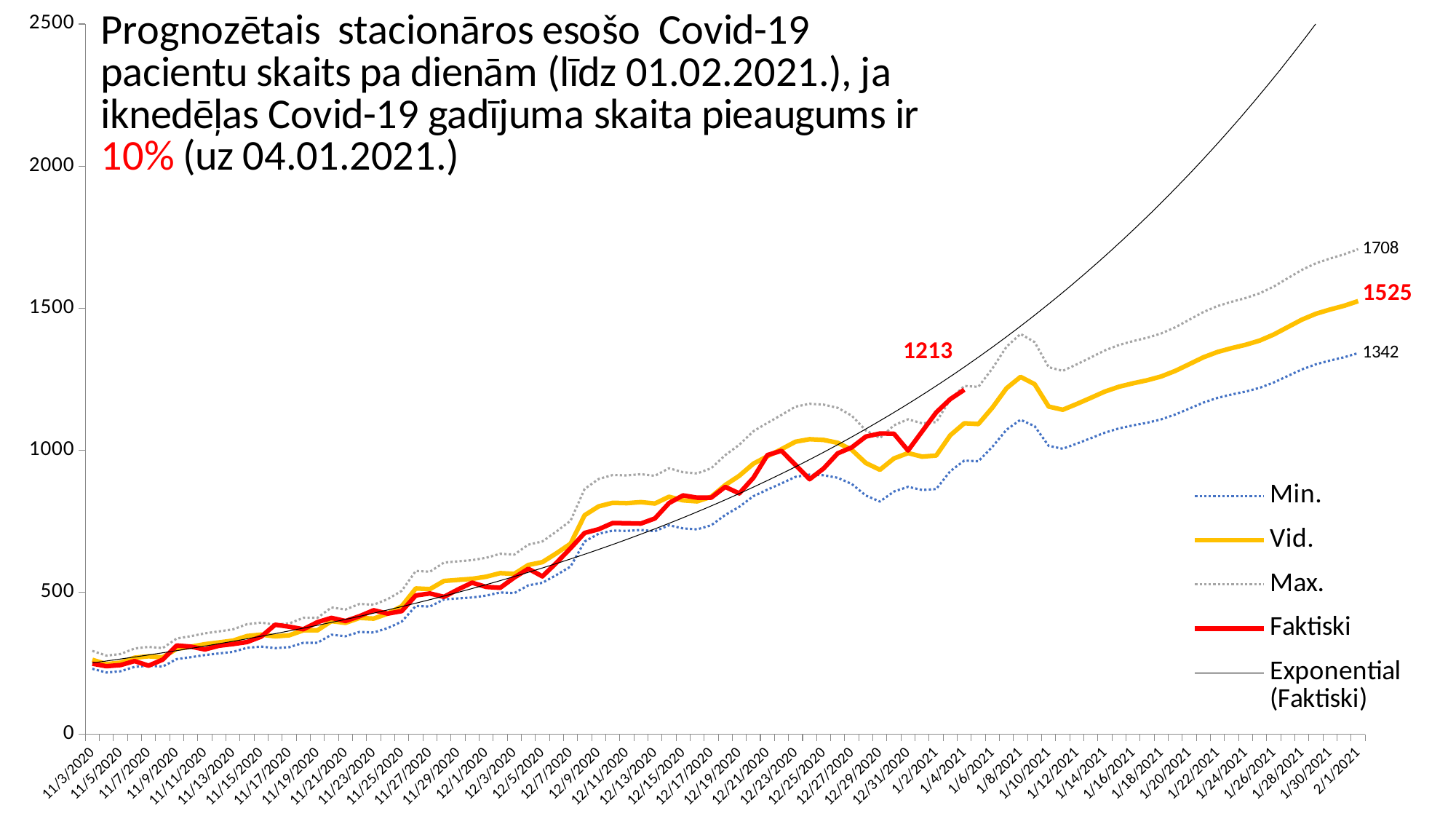
What is the last labelled value of the Faktiski series? 1213 How many series does the legend list? 5 What is the difference between the Max. and Min. values at 2/1/2021? 366 At 2/1/2021, which is larger: the Max. value or the Vid. value? Max. What is the value of the Max. series at 2/1/2021? 1708 What is the difference between the Vid. and Min. values at 2/1/2021? 183 What is the value of the Min. series at 2/1/2021? 1342 Which series has the lowest value at 2/1/2021? Min. What kind of chart is shown on the slide? line chart Is the value of the Exponential (Faktiski) line at 2/1/2021 greater or less than 2000? greater What is the value of the Vid. series at 2/1/2021? 1525 Does the Vid. series generally rise or fall from 11/3/2020 to 2/1/2021? rise